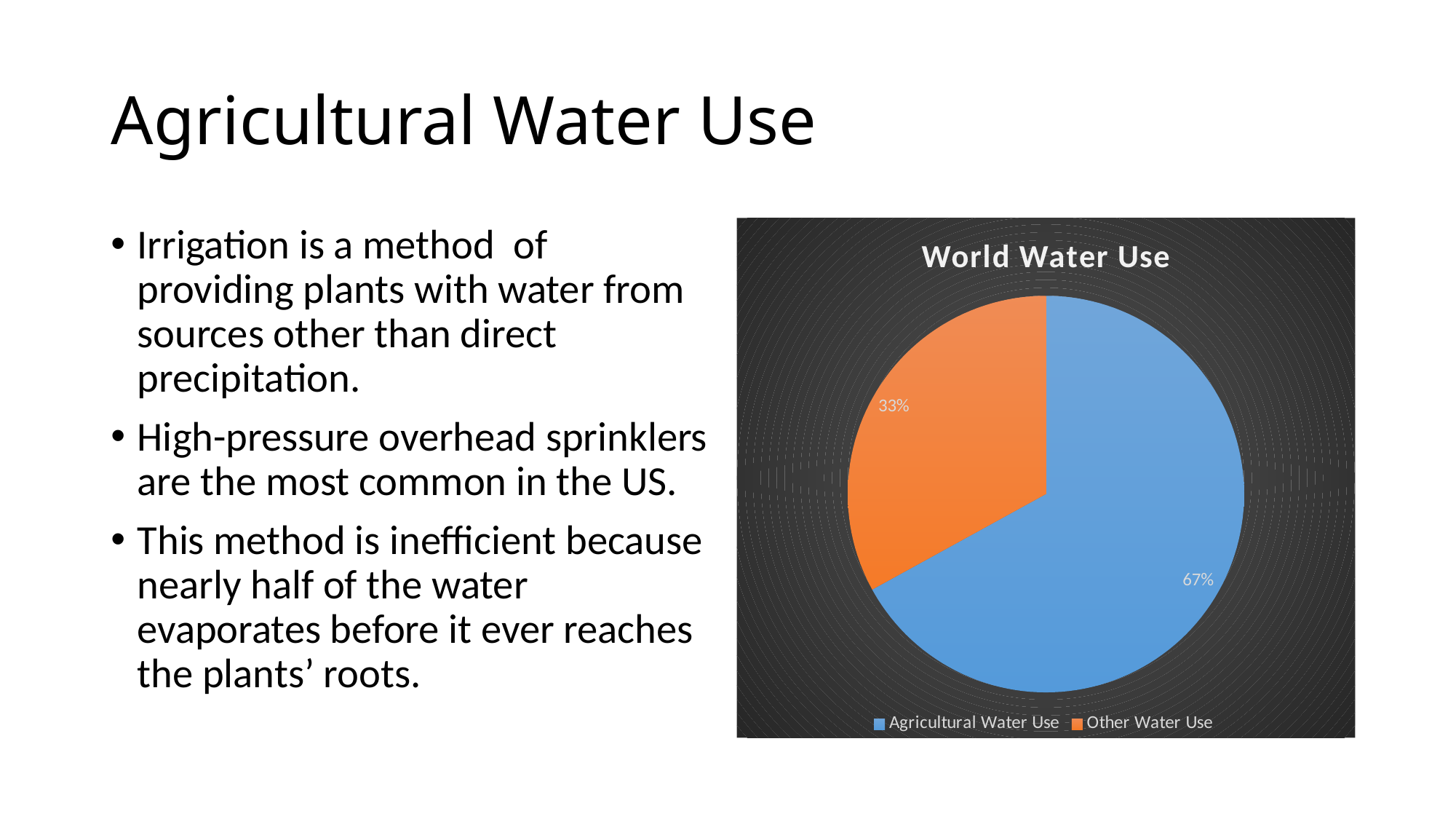
Which is larger, Agricultural Water Use or Other Water Use? Agricultural Water Use How many slices does the pie chart have? 2 How many entries does the legend list? 2 Which category has the smallest slice of the pie? Other Water Use Which category has the largest slice of the pie? Agricultural Water Use What share of the pie is Agricultural Water Use? 67% What colour is the Other Water Use slice? orange What is the value labelled on the blue slice? 67% What is the difference in percentage points between Agricultural Water Use and Other Water Use? 34 What kind of chart is shown on the slide? pie chart What share of the pie is Other Water Use? 33% What is the title of the chart? World Water Use